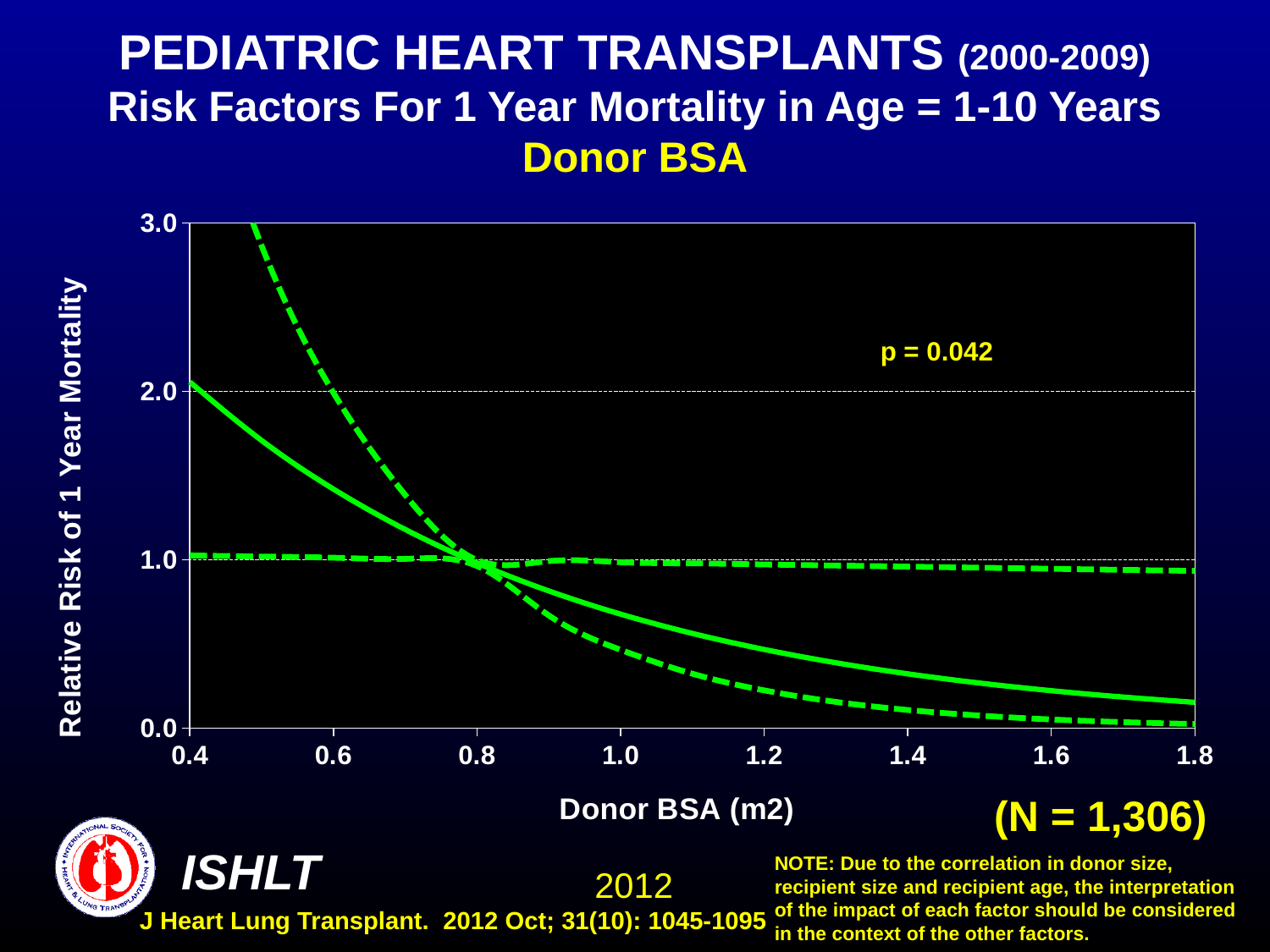
Is the value of the solid line at a Donor BSA of 0.6 greater or less than 2.0? less What p-value is printed on the chart? p = 0.042 Is the value of the solid line at a Donor BSA of 1.2 greater or less than 1.0? less Is the value of the solid line at a Donor BSA of 0.6 greater or less than 1.0? greater What is the highest value shown on the y axis? 3.0 What kind of chart is shown on the slide? line chart What is the sample size (N) shown on the slide? N = 1,306 How many lines are plotted on the chart? 3 Does the solid line for relative risk rise or fall as Donor BSA increases from 0.4 to 1.8? fall